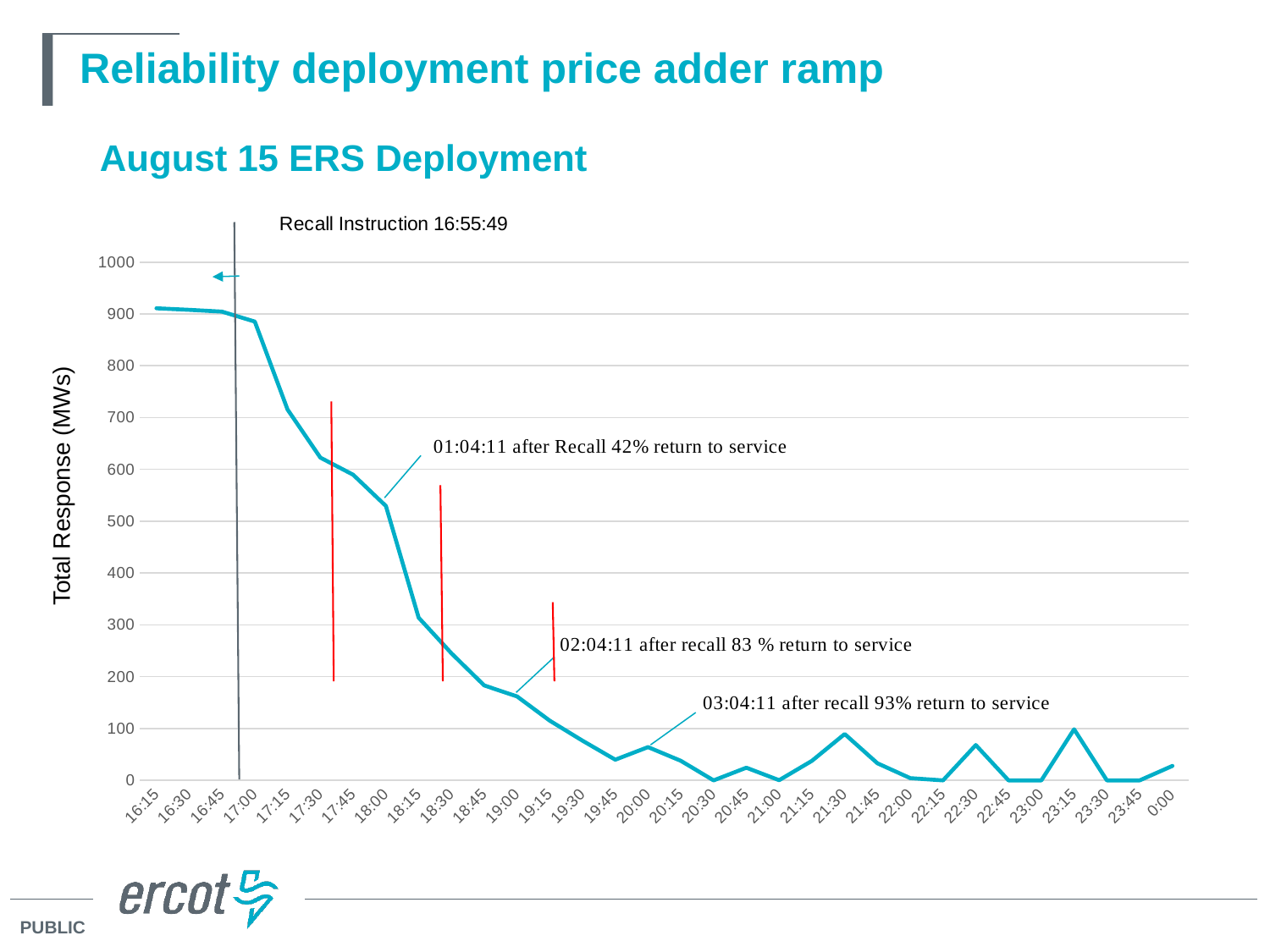
What is the label of the y axis? Total Response (MWs) According to the chart annotation, what percentage had returned to service 02:04:11 after recall? 83 % What is the title of the chart? August 15 ERS Deployment Is the value at 16:15 greater or less than 800? greater Overall, does the total response rise or fall from 16:15 to 0:00? Fall At what time was the recall instruction issued, according to the chart annotation? 16:55:49 What kind of chart is shown on the slide? Line chart Is the value at 19:45 greater or less than 100? less Which is larger, the value at 17:00 or the value at 18:00? 17:00 Is the value at 18:15 greater or less than 400? less How many time points are labelled on the x axis? 32